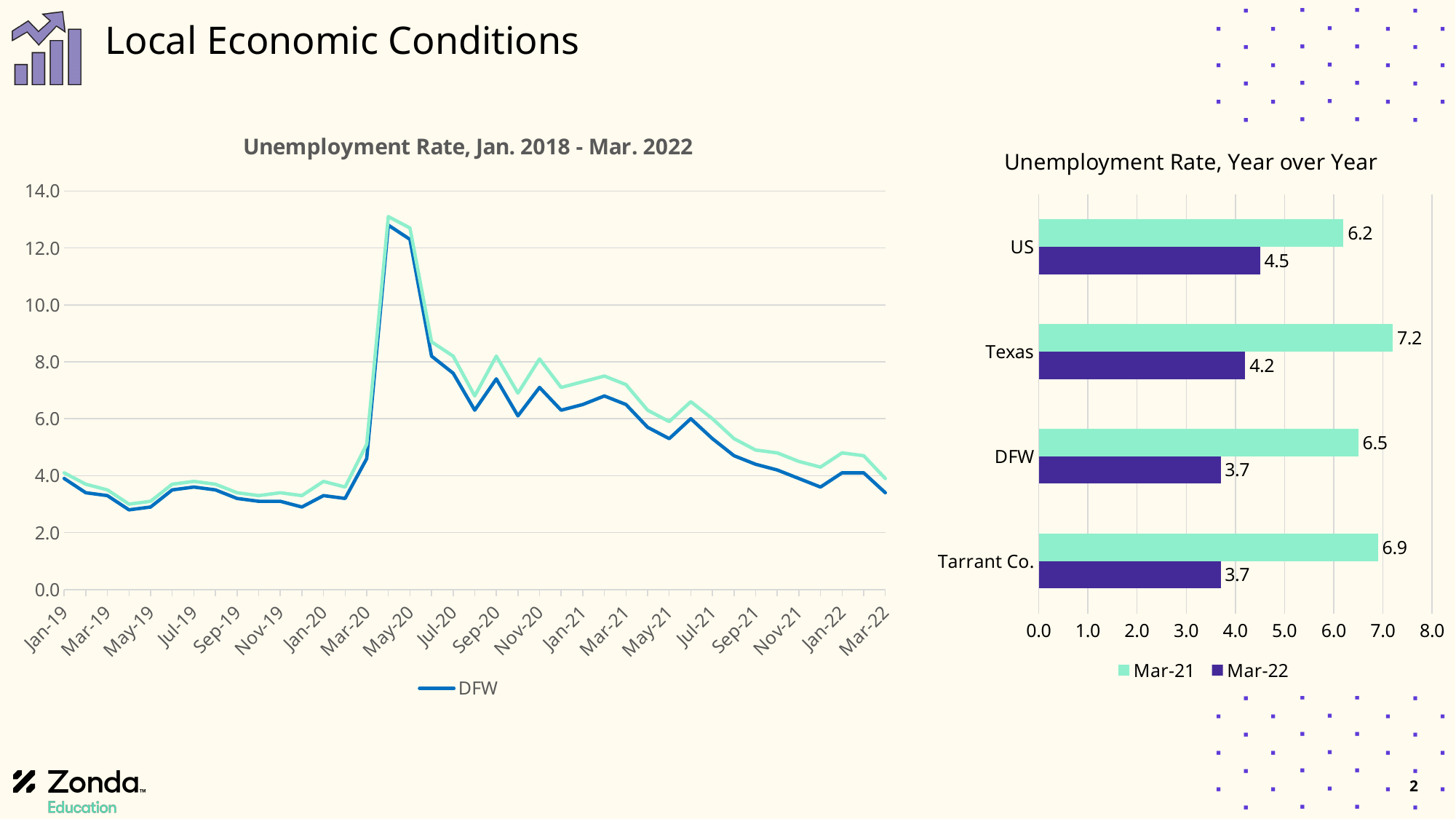
In the 'Unemployment Rate, Year over Year' chart, which category has the highest Mar-21 value? Texas In the 'Unemployment Rate, Year over Year' chart, which is larger: the Mar-22 value for US or the Mar-22 value for Texas? US In the 'Unemployment Rate, Year over Year' chart, what is the difference between the Mar-21 and Mar-22 values for DFW? 2.8 In the 'Unemployment Rate, Year over Year' chart, what is the Mar-22 value for Tarrant Co.? 3.7 How many series does the legend of the 'Unemployment Rate, Year over Year' chart list? 2 How many categories are shown in the 'Unemployment Rate, Year over Year' chart? 4 What kind of chart is the 'Unemployment Rate, Year over Year' chart? Bar chart In the 'Unemployment Rate, Year over Year' chart, what is the Mar-22 value for US? 4.5 In the 'Unemployment Rate, Jan. 2018 - Mar. 2022' chart, is the peak value of the DFW line greater or less than 12.0? greater What kind of chart is the 'Unemployment Rate, Jan. 2018 - Mar. 2022' chart? Line chart In the 'Unemployment Rate, Year over Year' chart, which category has the lowest Mar-21 value? US In the 'Unemployment Rate, Year over Year' chart, what is the Mar-21 value for Texas? 7.2